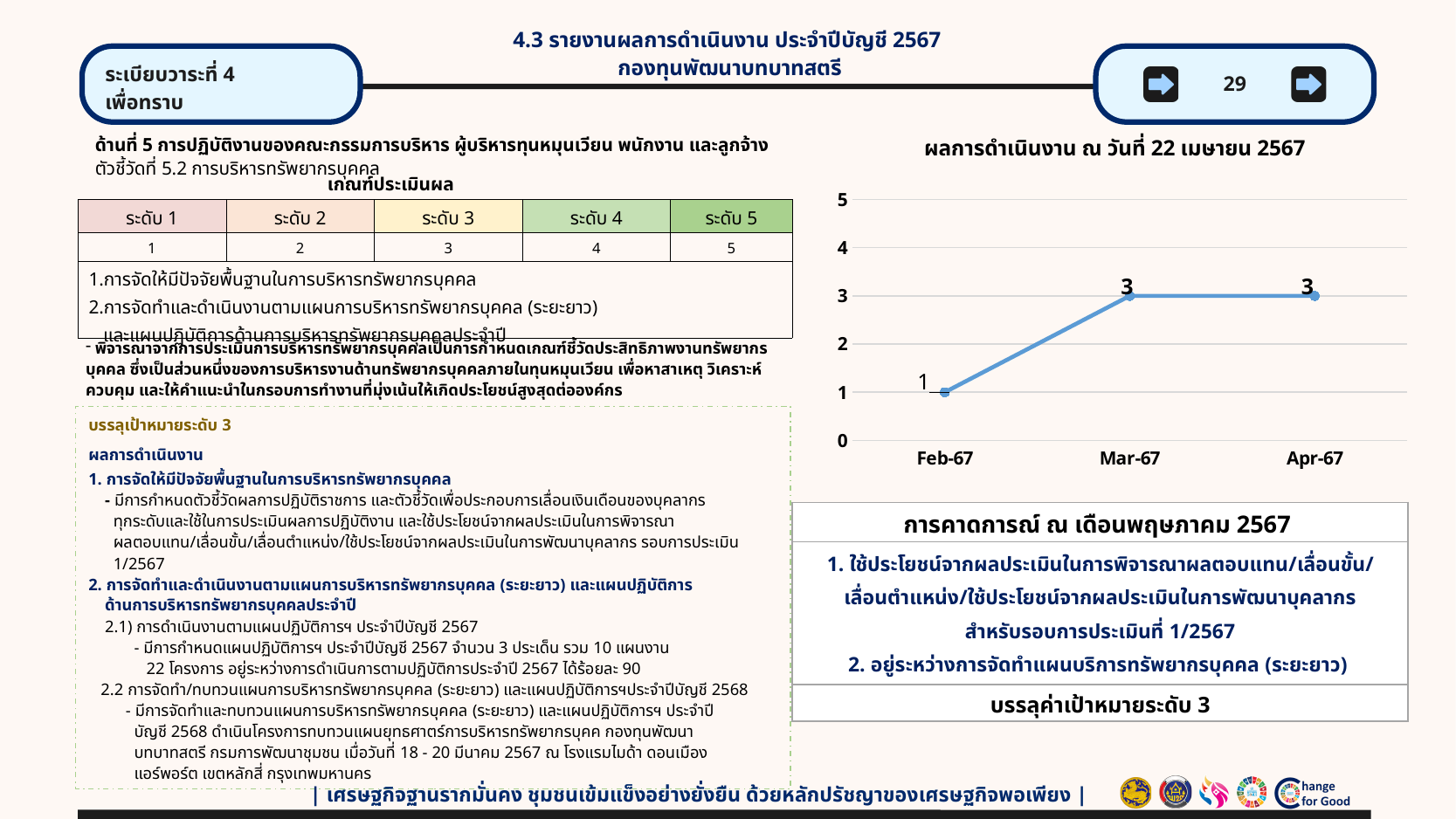
What is the difference between the values for Mar-67 and Feb-67? 2 Is the value for Mar-67 greater or less than 2? greater What is the value for Apr-67? 3 What is the title of the chart? ผลการดำเนินงาน ณ วันที่ 22 เมษายน 2567 What is the value for Feb-67? 1 What kind of chart is shown on the slide? line chart Which is larger, the value for Feb-67 or the value for Apr-67? Apr-67 How many data points are plotted on the chart? 3 Do the values rise or fall from Feb-67 to Mar-67? rise What is the highest value shown on the y axis? 5 What is the value for Mar-67? 3 Which month has the lowest value? Feb-67